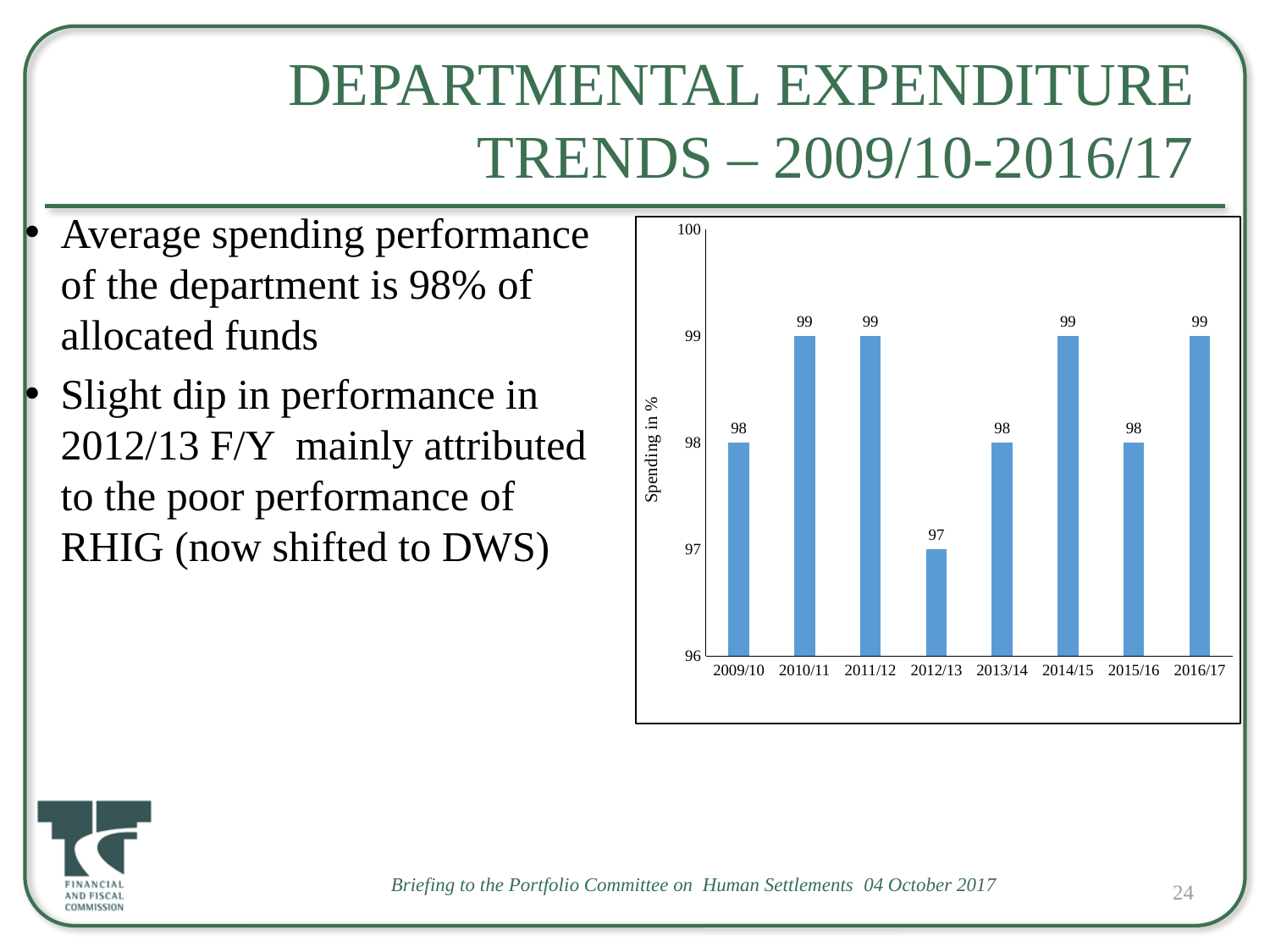
What is the difference between the spending percentage in 2011/12 and 2012/13? 2 Is the value for 2012/13 greater or less than 98? less What is the spending percentage for 2012/13? 97 Which is larger, the spending percentage for 2013/14 or for 2014/15? 2014/15 Which year has the lowest spending percentage? 2012/13 How many years are shown on the x axis of the chart? 8 What kind of chart is shown on the slide? bar chart What is the spending percentage for 2016/17? 99 How many years have a spending percentage of 99? 4 What is the label of the y axis of the chart? Spending in % What is the spending percentage for 2009/10? 98 Does the spending percentage rise or fall from 2012/13 to 2013/14? rise